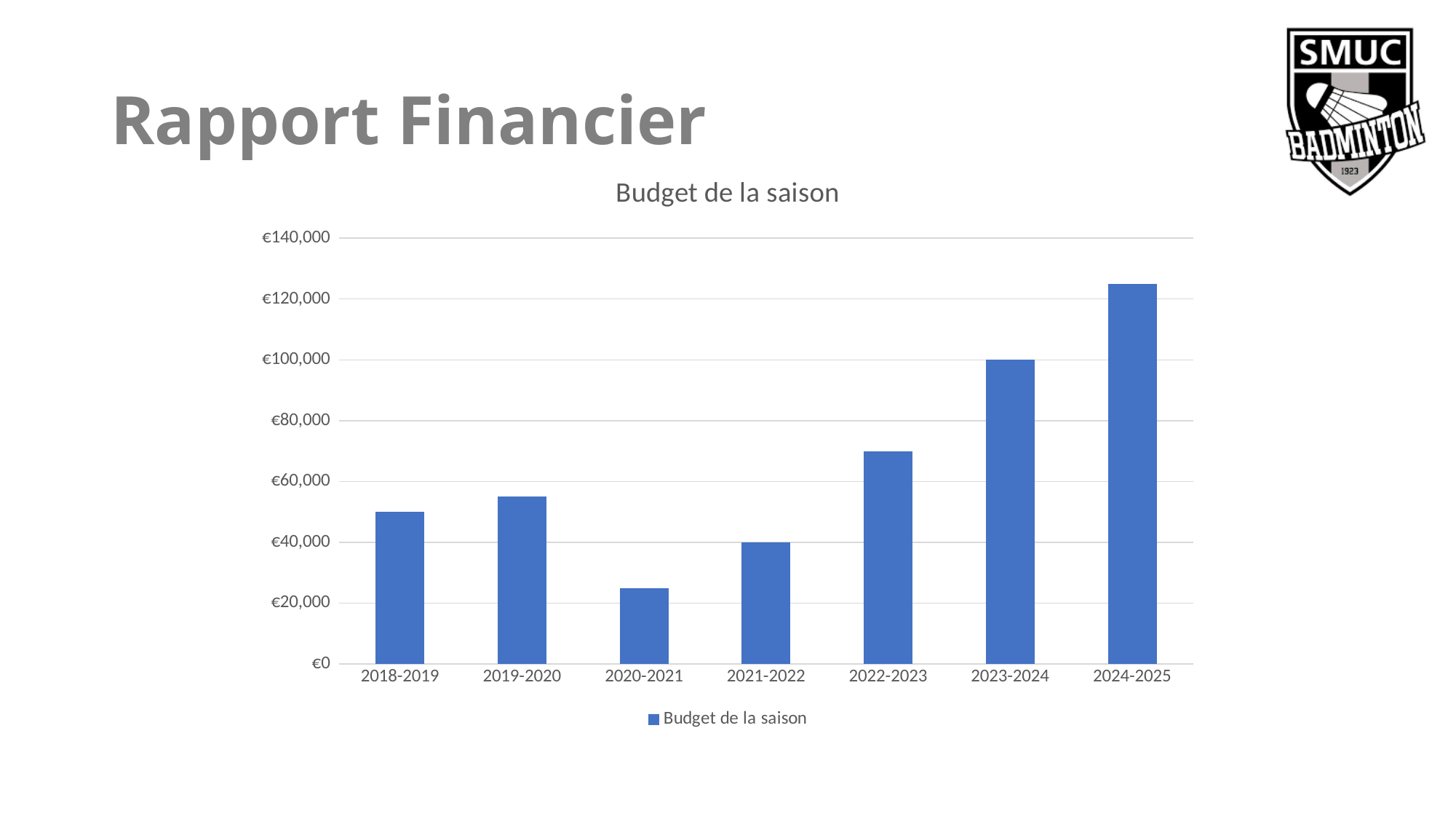
Which season has the highest budget? 2024-2025 What is the budget for the 2023-2024 season? €100,000 What is the title of the chart? Budget de la saison From 2020-2021 to 2024-2025, do the budget values rise or fall? rise What is the difference between the budgets for 2023-2024 and 2021-2022? €60,000 Which season has the larger budget, 2022-2023 or 2019-2020? 2022-2023 What type of chart is shown on the slide? bar chart Is the budget for 2024-2025 greater or less than €120,000? greater How many seasons are shown on the x axis of the chart? 7 What is the budget for the 2021-2022 season? €40,000 How many series does the legend list? 1 Which season has the lowest budget? 2020-2021